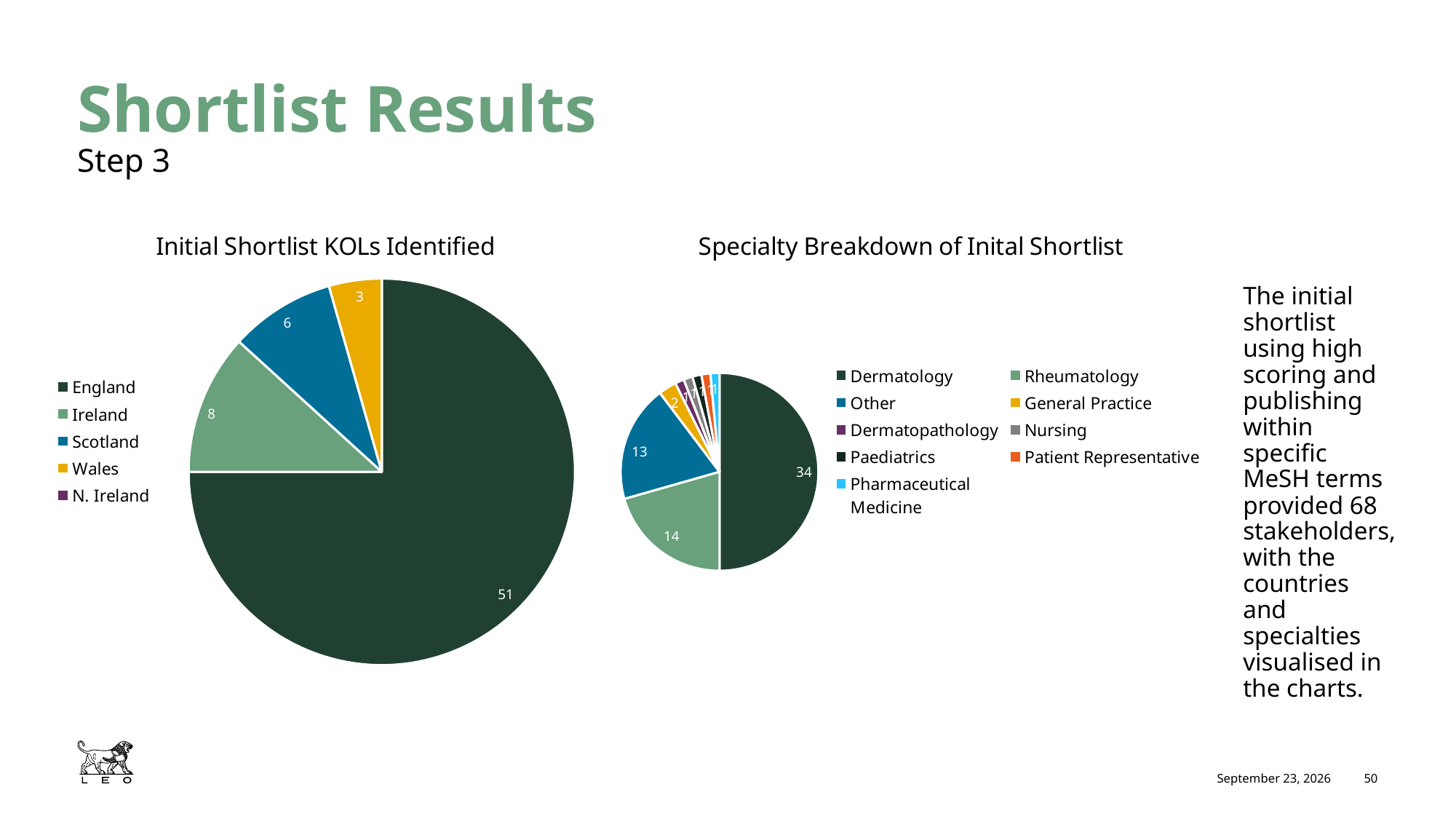
How many entries does the legend of the 'Specialty Breakdown of Inital Shortlist' chart list? 9 In the 'Initial Shortlist KOLs Identified' chart, which is larger, Ireland or Scotland? Ireland What kind of chart is the 'Initial Shortlist KOLs Identified' chart? Pie chart In the 'Specialty Breakdown of Inital Shortlist' chart, what is the difference between Dermatology and Rheumatology? 20 In the 'Initial Shortlist KOLs Identified' chart, which country has the largest slice? England In the 'Specialty Breakdown of Inital Shortlist' chart, what is the value for Other? 13 In the 'Specialty Breakdown of Inital Shortlist' chart, what is the value for Rheumatology? 14 In the 'Initial Shortlist KOLs Identified' chart, what is the value for England? 51 In the 'Specialty Breakdown of Inital Shortlist' chart, what is the value for Dermatology? 34 In the 'Initial Shortlist KOLs Identified' chart, what is the value for Scotland? 6 In the 'Initial Shortlist KOLs Identified' chart, what is the difference between the values for Ireland and Wales? 5 How many entries does the legend of the 'Initial Shortlist KOLs Identified' chart list? 5